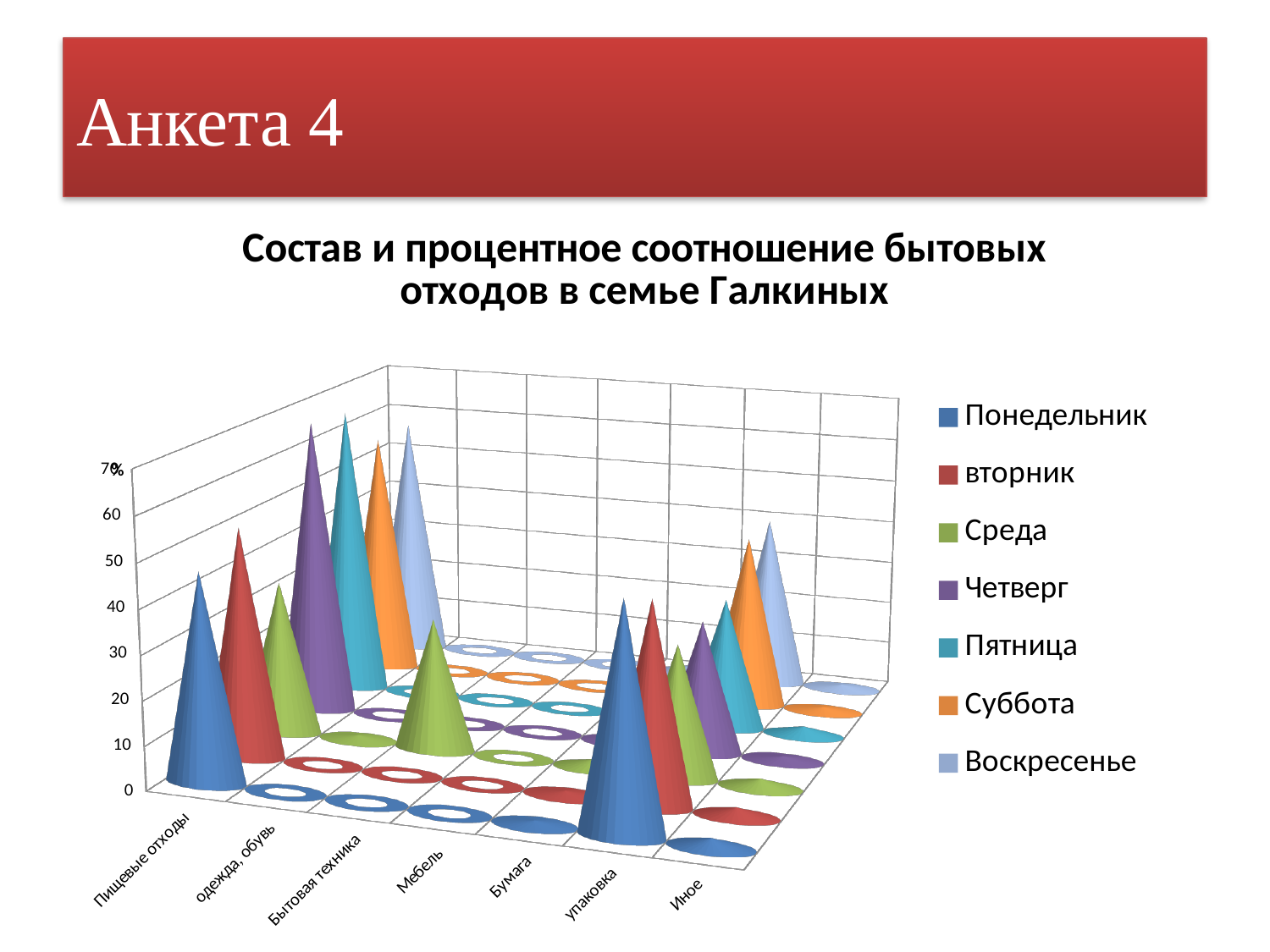
How many categories are shown on the x axis? 7 How many series does the legend list? 7 Which series is shown in blue in the legend? Понедельник For Воскресенье, which category has the larger value: Бытовая техника or Бумага? Бумага What kind of chart is shown on the slide? bar chart Is the value for Бумага on Понедельник greater or less than 10? less Is the value for Пищевые отходы on Понедельник greater or less than 20? greater What is the title of the chart? Состав и процентное соотношение бытовых отходов в семье Галкиных Is the value for Бытовая техника on Четверг greater or less than 20? less